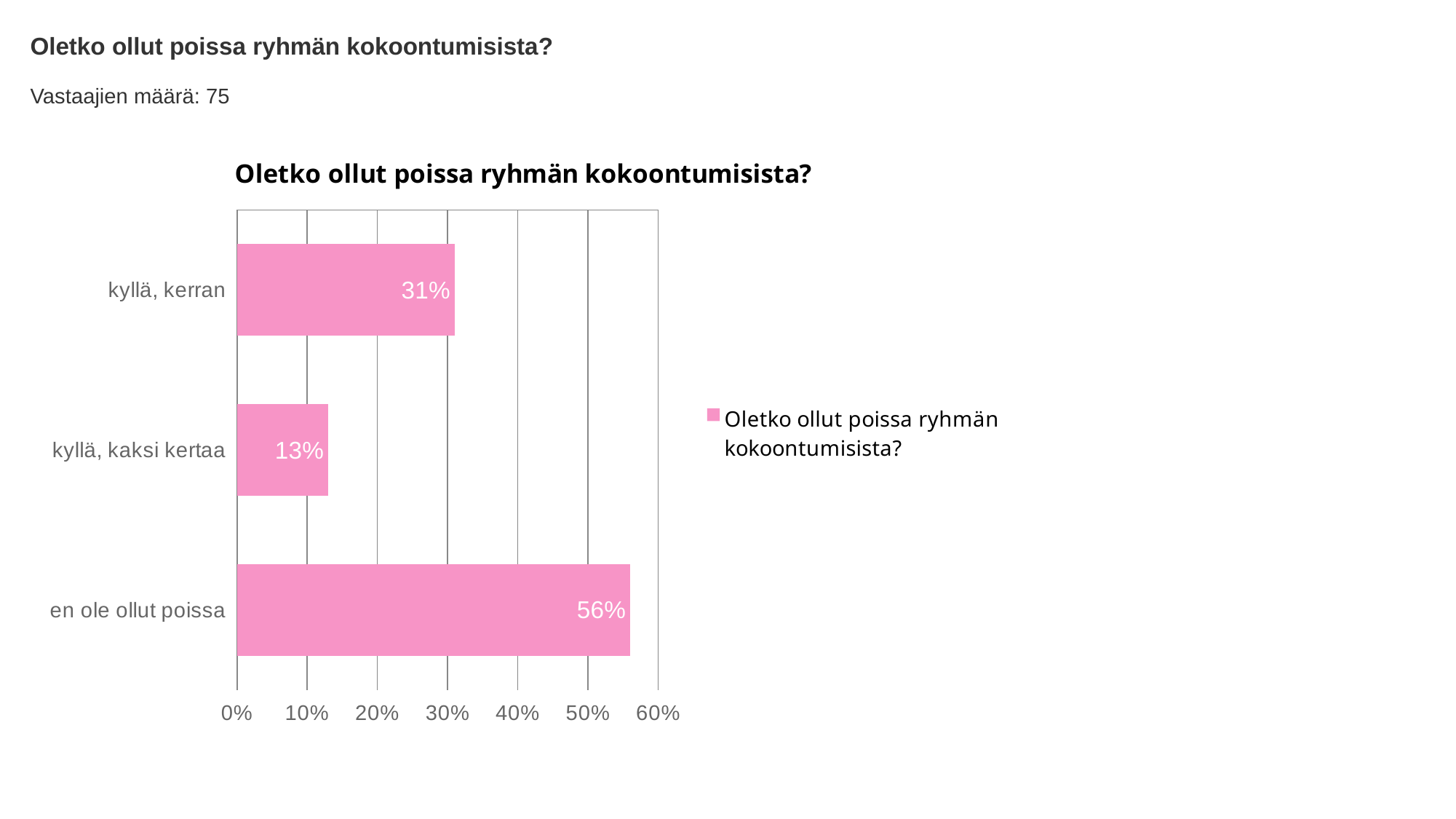
Which category has the lowest value? kyllä, kaksi kertaa What is the title of the chart? Oletko ollut poissa ryhmän kokoontumisista? What is the value for "kyllä, kaksi kertaa"? 13% What is the value for "en ole ollut poissa"? 56% Which category has the highest value? en ole ollut poissa Which is larger, the value for "kyllä, kerran" or the value for "kyllä, kaksi kertaa"? kyllä, kerran Is the value for "en ole ollut poissa" greater or less than 50%? greater How many categories are shown in the chart? 3 What is the difference between the values for "en ole ollut poissa" and "kyllä, kerran"? 25% What kind of chart is shown on the slide? bar chart What is the value for "kyllä, kerran"? 31% What is the difference between the values for "kyllä, kerran" and "kyllä, kaksi kertaa"? 18%